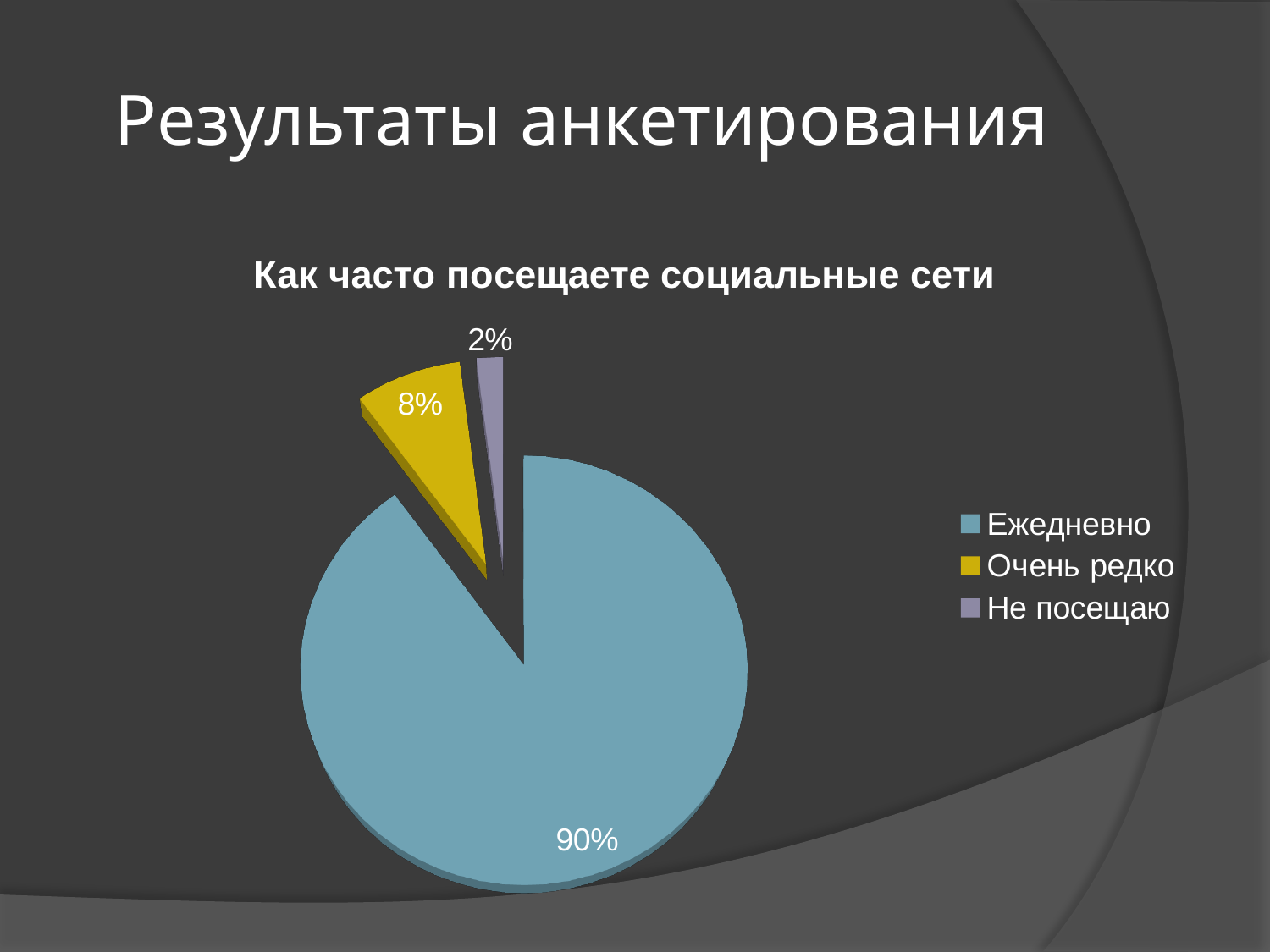
What share of the pie is labelled "Не посещаю"? 2% What share of the pie is labelled "Очень редко"? 8% Which is larger, the share for "Очень редко" or the share for "Не посещаю"? Очень редко What colour is the slice for "Ежедневно"? blue How many categories does the pie chart show? 3 What share of the pie is labelled "Ежедневно"? 90% What is the difference in percentage points between "Ежедневно" and "Очень редко"? 82 Which category has the largest slice of the pie? Ежедневно What is the title of the chart? Как часто посещаете социальные сети What kind of chart is shown on the slide? pie chart What is the difference in percentage points between "Очень редко" and "Не посещаю"? 6 Which category has the smallest slice of the pie? Не посещаю